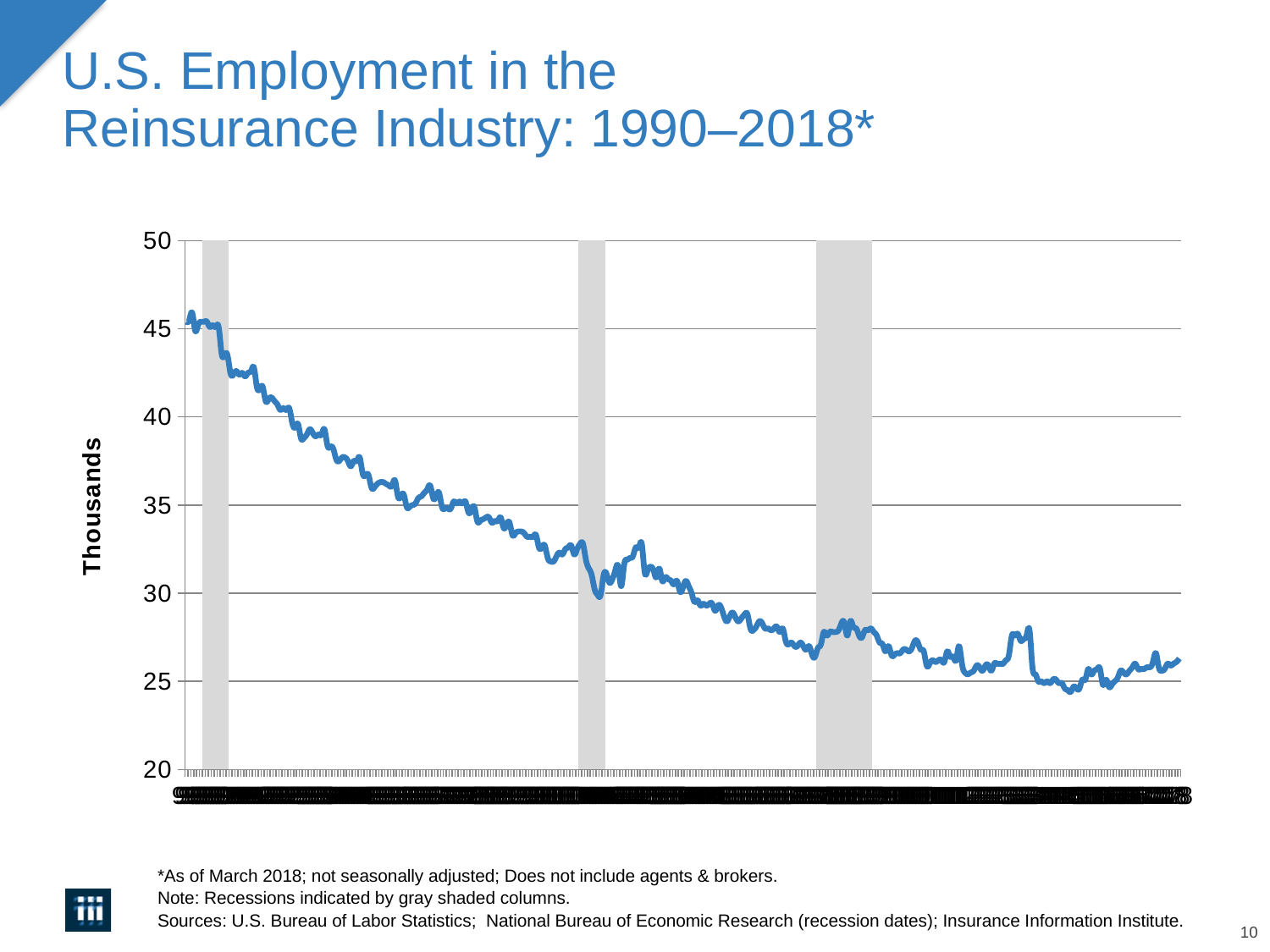
Is the value at the end of the series (right end of the line) greater or less than 30? less What is the highest value shown on the vertical axis? 50 What kind of chart is shown on the slide? line chart Is the highest point of the line greater or less than 50? less What is the label on the vertical axis of the chart? Thousands How many gray shaded recession columns appear on the chart? 3 What is the lowest value shown on the vertical axis? 20 Is the lowest point of the line greater or less than 25? less Do the values in the chart generally rise or fall from left to right across the period? fall